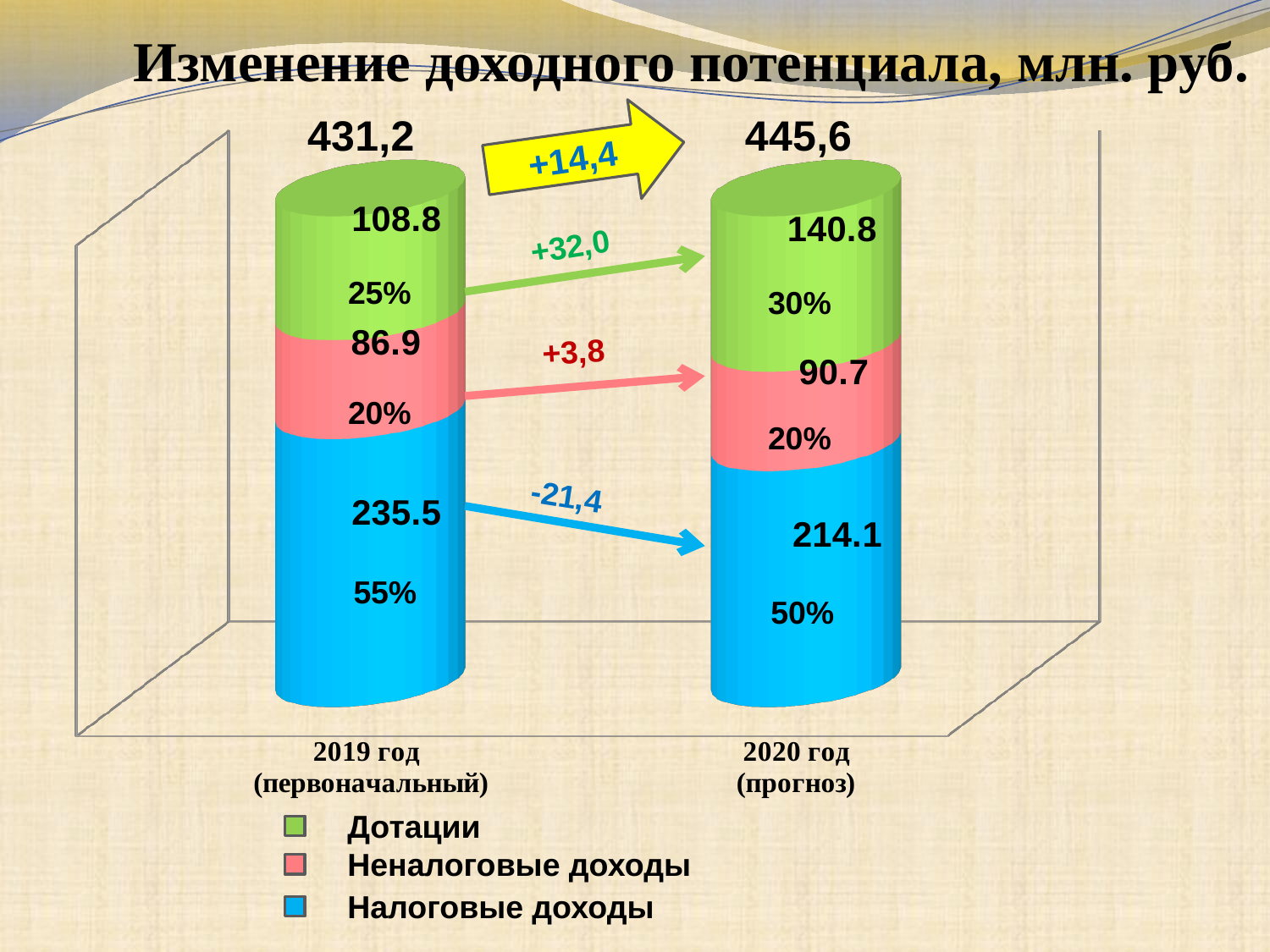
Which is larger: Дотации in 2019 год (первоначальный) or Дотации in 2020 год (прогноз)? 2020 год (прогноз) What is the difference between Налоговые доходы in 2019 год (первоначальный) and in 2020 год (прогноз)? 21.4 What is the total of the stacked bar for 2020 год (прогноз)? 445,6 What type of chart is shown on the slide? bar chart What is the value of Неналоговые доходы for 2019 год (первоначальный)? 86.9 How many series does the legend list? 3 What is the title of the chart? Изменение доходного потенциала, млн. руб. What is the total of the stacked bar for 2019 год (первоначальный)? 431,2 What share of the 2020 год (прогноз) bar is Налоговые доходы? 50% How many categories are shown on the x axis? 2 What is the value of Дотации for 2020 год (прогноз)? 140.8 What is the value of Налоговые доходы for 2019 год (первоначальный)? 235.5